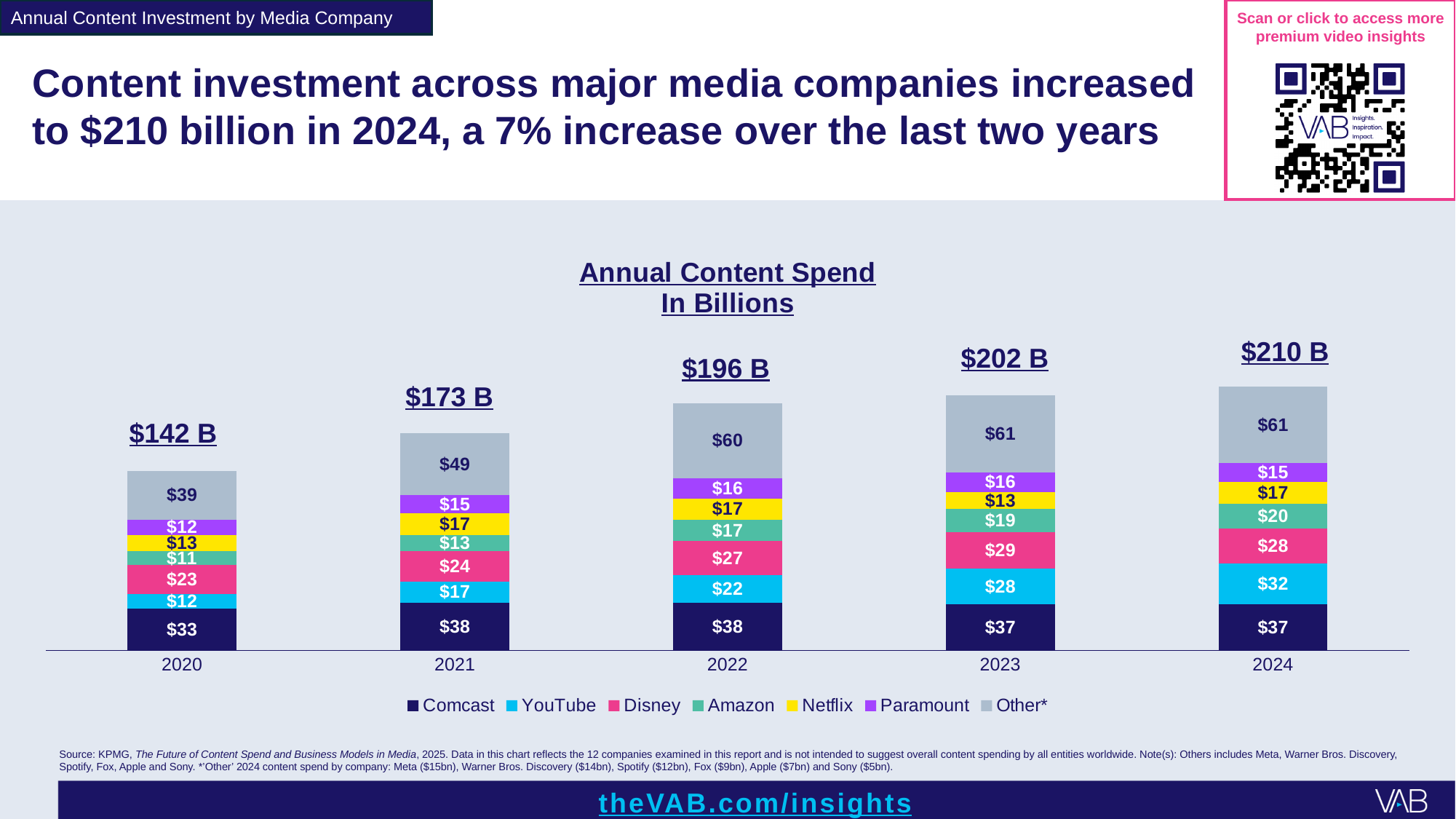
What is the total annual content spend shown for 2020? $142 B What is the value for Disney in 2023? $29 What is the value for YouTube in 2024? $32 How many series does the legend list? 7 Which year has the lowest total annual content spend? 2020 What is the total annual content spend shown for 2024? $210 B What is the difference between the YouTube value in 2024 and the YouTube value in 2020? $20 Do the total annual content spend values rise or fall from 2020 to 2024? Rise Which year has the highest total annual content spend? 2024 What is the value for Other* in 2021? $49 What type of chart is shown on the slide? Stacked bar chart How many years are shown on the x axis? 5